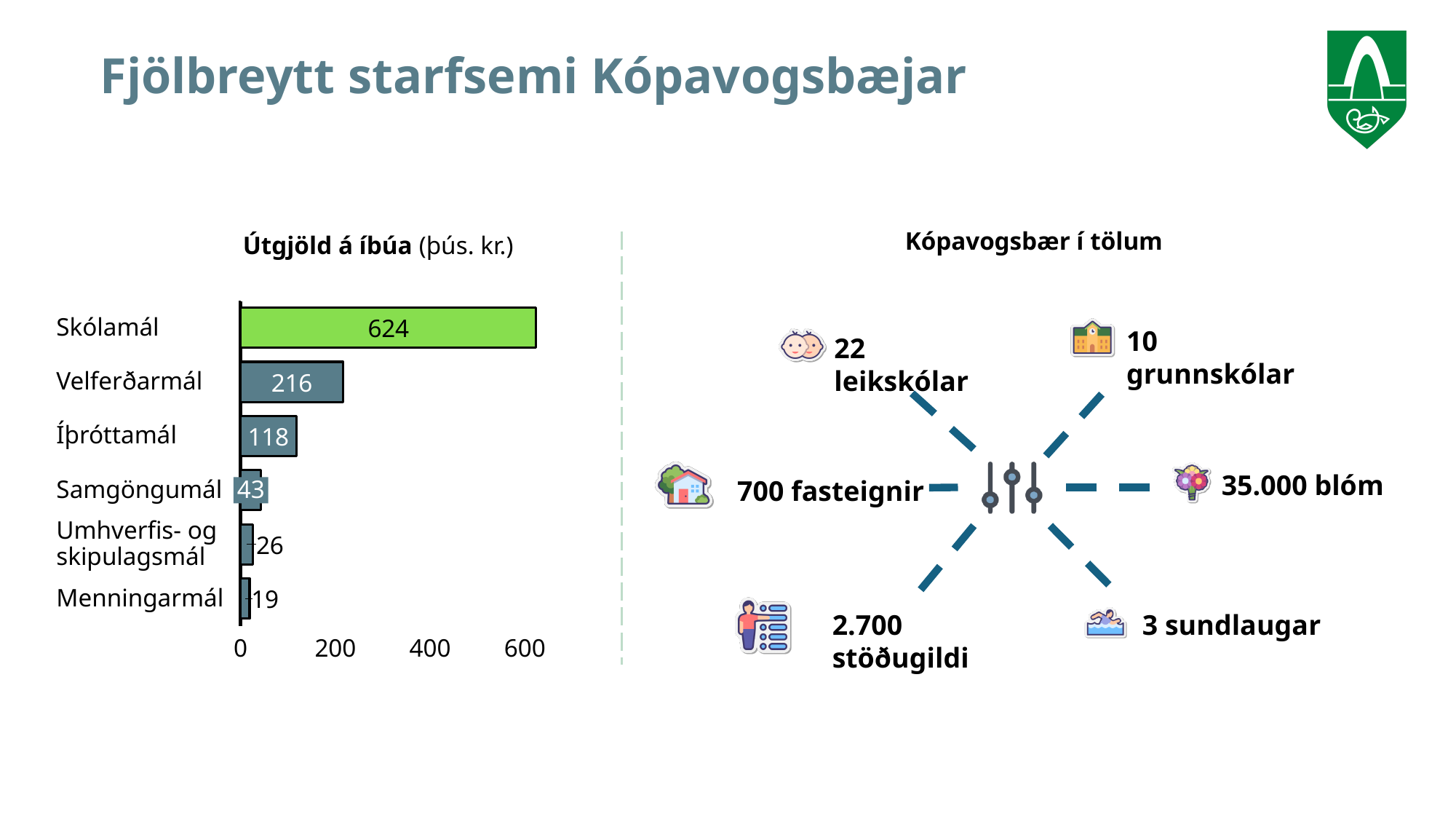
Which category has the highest value in the Útgjöld á íbúa chart? Skólamál Which category has the lowest value in the Útgjöld á íbúa chart? Menningarmál Which is larger in the Útgjöld á íbúa chart, Íþróttamál or Samgöngumál? Íþróttamál What is the difference between the values for Skólamál and Velferðarmál in the Útgjöld á íbúa chart? 408 What kind of chart is the Útgjöld á íbúa chart? Bar chart What is the value for Menningarmál in the Útgjöld á íbúa chart? 19 How many categories are shown in the Útgjöld á íbúa chart? 6 What is the value for Skólamál in the Útgjöld á íbúa chart? 624 What is the value for Velferðarmál in the Útgjöld á íbúa chart? 216 What unit is given in the title of the Útgjöld á íbúa chart? þús. kr. What is the value for Samgöngumál in the Útgjöld á íbúa chart? 43 What is the value for Íþróttamál in the Útgjöld á íbúa chart? 118